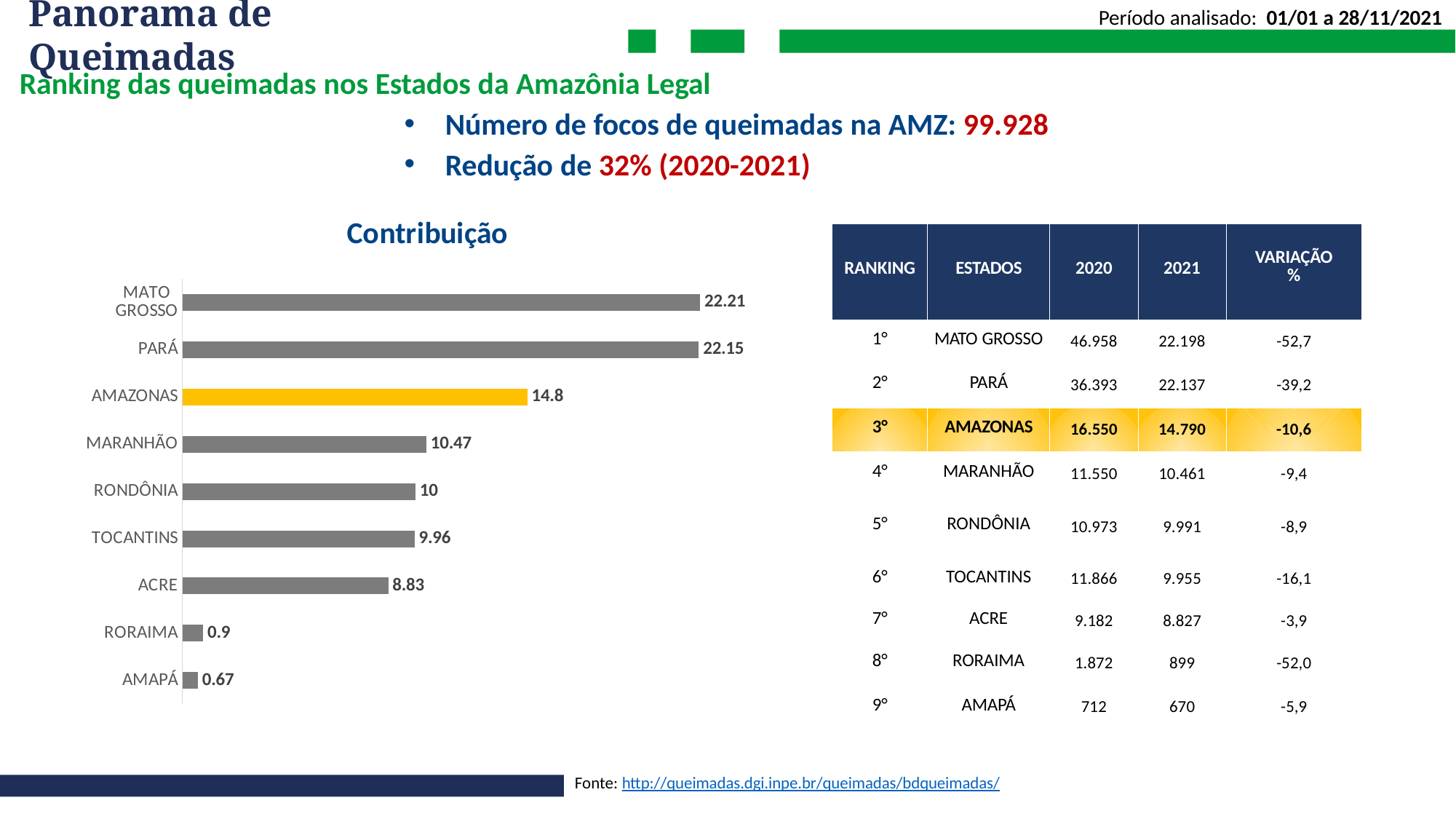
Which state has the lowest value in the Contribuição chart? AMAPÁ What is the value for AMAZONAS in the Contribuição chart? 14.8 What is the difference between the values for AMAZONAS and MARANHÃO in the Contribuição chart? 4.33 What is the value for ACRE in the Contribuição chart? 8.83 In the Contribuição chart, which is larger: the value for RONDÔNIA or the value for ACRE? RONDÔNIA How many states are shown in the Contribuição chart? 9 Which state's bar is highlighted in yellow in the Contribuição chart? AMAZONAS What kind of chart is the Contribuição chart? Bar chart What is the value for AMAPÁ in the Contribuição chart? 0.67 What is the value for MARANHÃO in the Contribuição chart? 10.47 Which state has the highest value in the Contribuição chart? MATO GROSSO What is the difference between the values for ACRE and RORAIMA in the Contribuição chart? 7.93